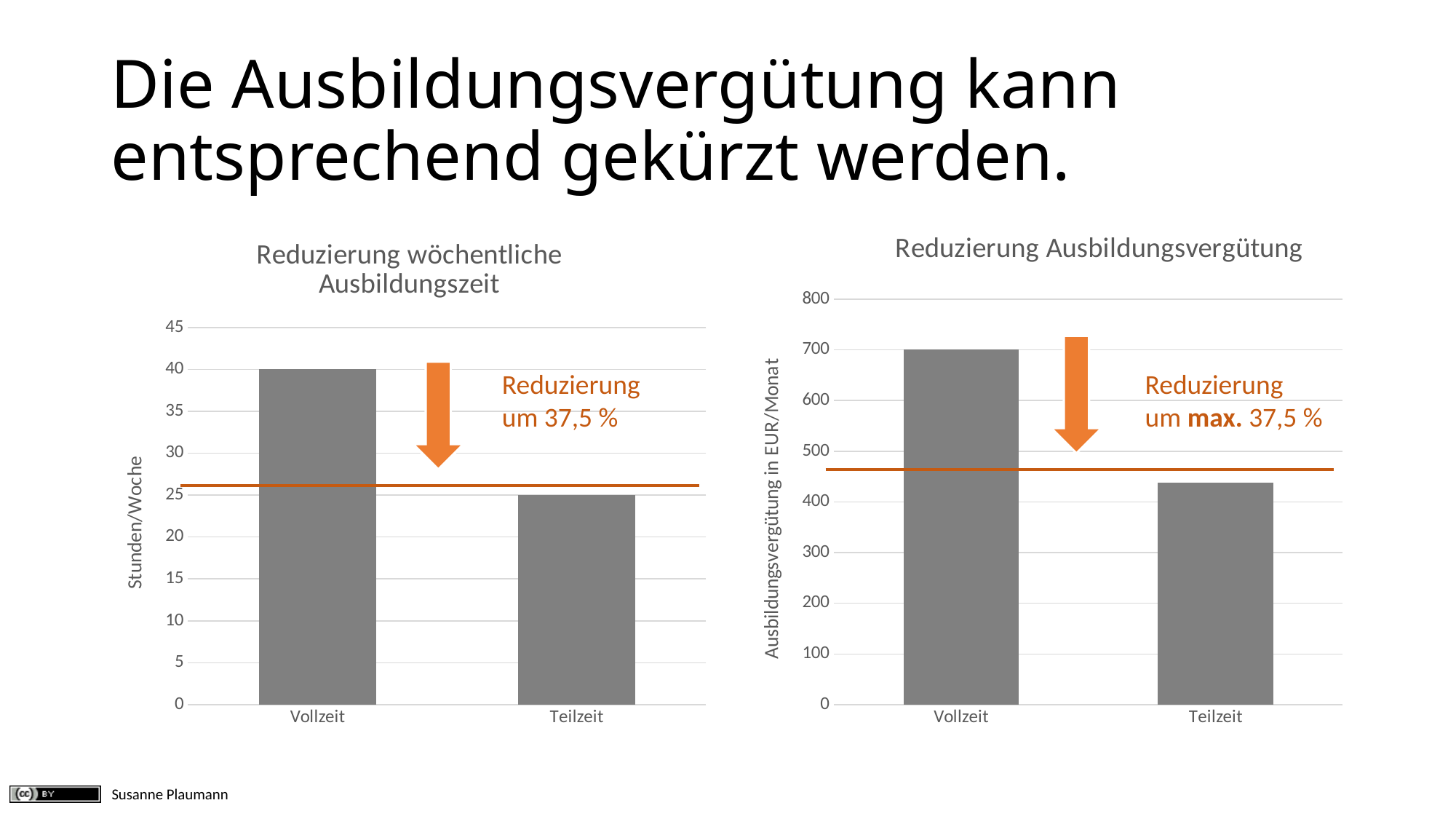
In the chart titled "Reduzierung Ausbildungsvergütung", is the value for Teilzeit greater or less than 500? less What is the y-axis label of the chart titled "Reduzierung wöchentliche Ausbildungszeit"? Stunden/Woche How many categories are shown in the chart titled "Reduzierung wöchentliche Ausbildungszeit"? 2 In the chart titled "Reduzierung Ausbildungsvergütung", which category has the lowest value? Teilzeit In the chart titled "Reduzierung wöchentliche Ausbildungszeit", which category has the highest value? Vollzeit In the chart titled "Reduzierung wöchentliche Ausbildungszeit", what is the value for Vollzeit? 40 In the chart titled "Reduzierung Ausbildungsvergütung", is the value for Teilzeit greater or less than 400? greater In the chart titled "Reduzierung wöchentliche Ausbildungszeit", what is the value for Teilzeit? 25 In the chart titled "Reduzierung wöchentliche Ausbildungszeit", what is the difference between the Vollzeit and Teilzeit values? 15 What kind of chart is the chart titled "Reduzierung Ausbildungsvergütung"? bar chart In the chart titled "Reduzierung Ausbildungsvergütung", which is larger, Vollzeit or Teilzeit? Vollzeit In the chart titled "Reduzierung Ausbildungsvergütung", what is the value for Vollzeit? 700